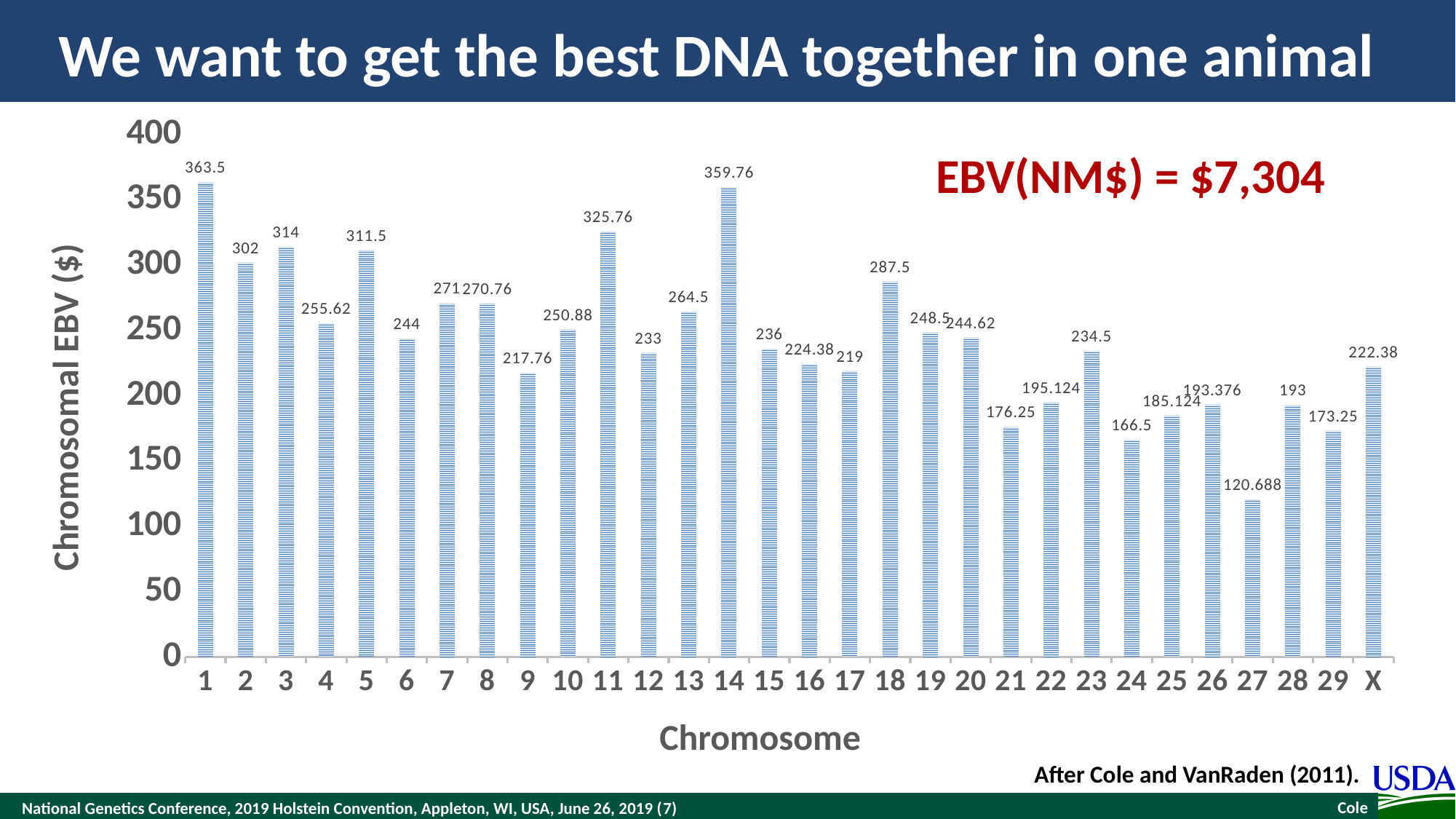
Which has a larger chromosomal EBV, chromosome 11 or chromosome 18? Chromosome 11 What is the chromosomal EBV value for chromosome X? 222.38 What is the difference between the chromosomal EBV values for chromosome 2 and chromosome 3? 12 What is the chromosomal EBV value for chromosome 14? 359.76 What is the chromosomal EBV value for chromosome 1? 363.5 Which chromosome has the lowest chromosomal EBV? 27 What is the label of the y axis of the chart? Chromosomal EBV ($) How many chromosomes are shown on the x axis of the chart? 30 What kind of chart is shown on the slide? Bar chart Which chromosome has the highest chromosomal EBV? 1 What is the chromosomal EBV value for chromosome 27? 120.688 Is the chromosomal EBV value for chromosome 24 greater or less than 200? less